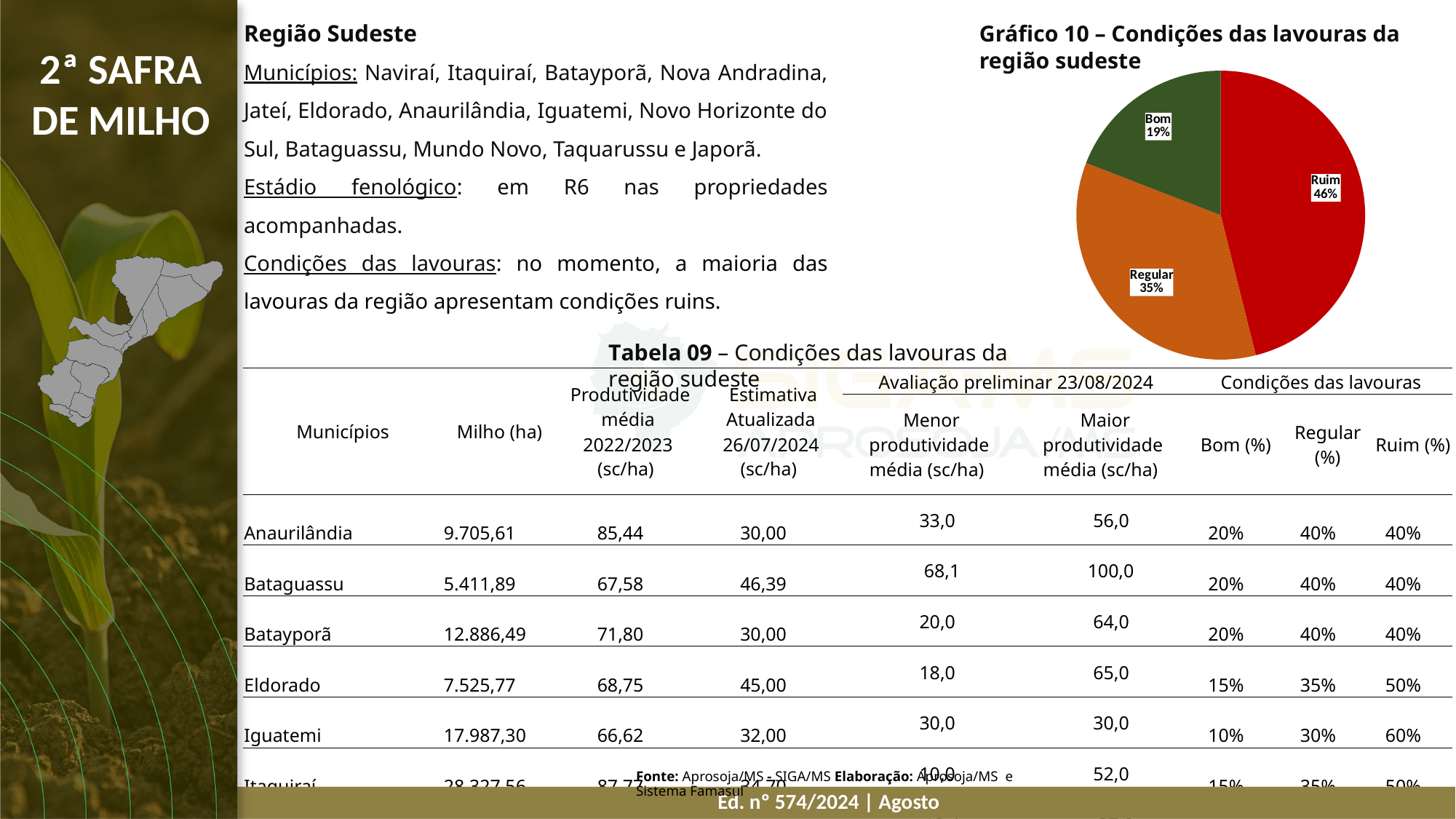
In Gráfico 10, what share of the pie is labelled Regular? 35% In Gráfico 10, which condition category has the largest slice? Ruim In Gráfico 10, what colour is the Ruim slice? Red In Gráfico 10, how many percentage points larger is the Ruim slice than the Bom slice? 27 What kind of chart is Gráfico 10? Pie chart In Gráfico 10, which slice is larger, Regular or Bom? Regular How many slices does the pie in Gráfico 10 have? 3 In Gráfico 10, how many percentage points larger is the Ruim slice than the Regular slice? 11 In Gráfico 10, which condition category has the smallest slice? Bom In Gráfico 10, what share of the pie is labelled Bom? 19% What is the title of the pie chart on the slide? Gráfico 10 – Condições das lavouras da região sudeste In Gráfico 10, what share of the pie is labelled Ruim? 46%